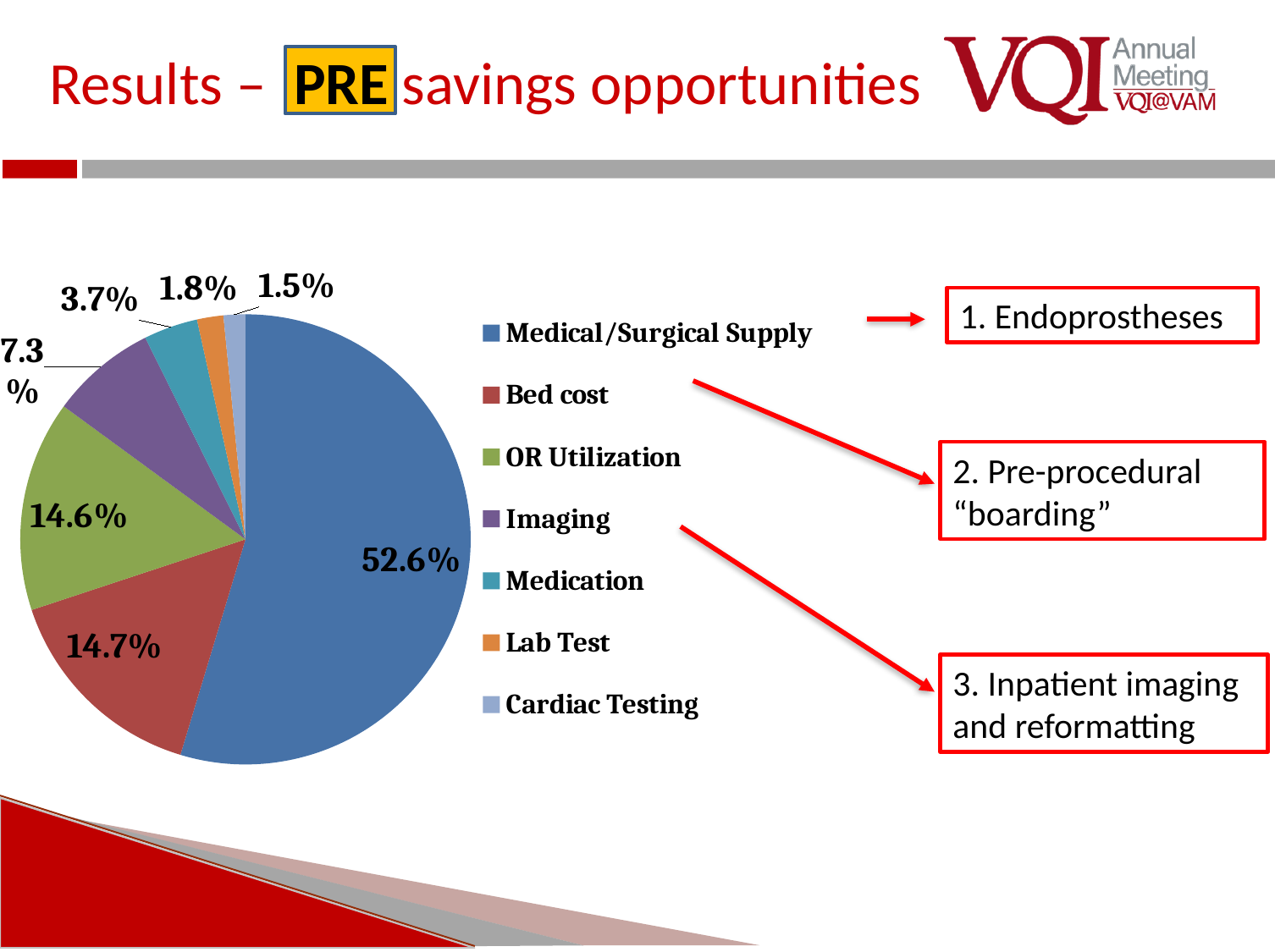
What is the value shown for Imaging? 7.3% How many categories does the pie chart have? 7 What share of the pie does Medical/Surgical Supply represent? 52.6% Which category has the largest slice of the pie? Medical/Surgical Supply What is the difference between the Medical/Surgical Supply share and the Bed cost share? 37.9% Which category has the smallest slice of the pie? Cardiac Testing What is the value shown for OR Utilization? 14.6% Which is larger, the slice for Imaging or the slice for Medication? Imaging What colour is the Lab Test slice in the pie chart? orange What is the value shown for Bed cost? 14.7% What is the value shown for Cardiac Testing? 1.5% What kind of chart is shown on the slide? pie chart